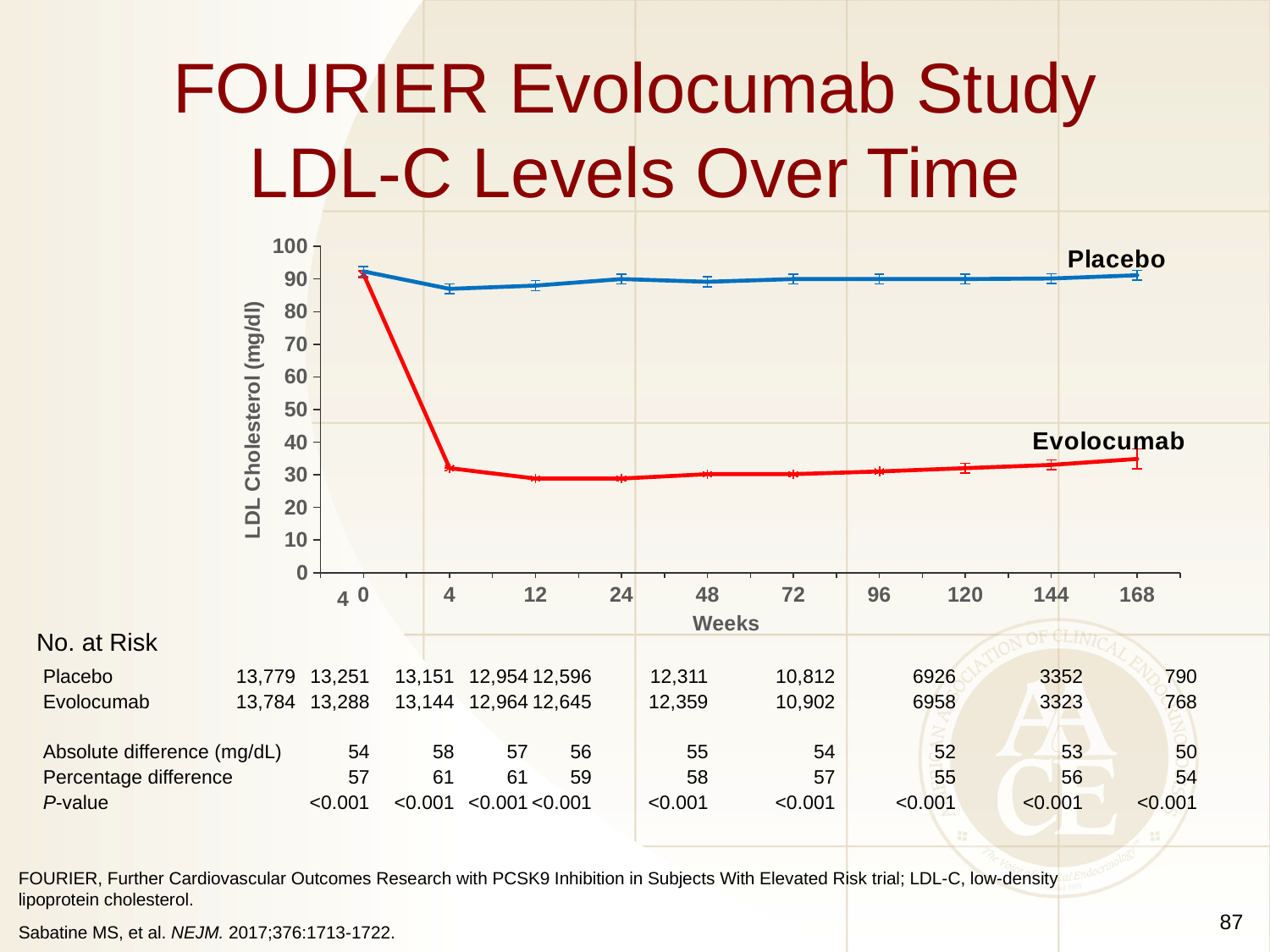
At week 48, which series has the higher value, Placebo or Evolocumab? Placebo What kind of chart is shown on the slide? line chart Is the value for Evolocumab at week 0 greater or less than 80? greater Which series has the lowest value on the chart at week 12? Evolocumab What is the label of the y axis of the chart? LDL Cholesterol (mg/dl) What are the names of the two series plotted on the chart? Placebo and Evolocumab Is the value for Evolocumab at week 4 greater or less than 50? less How many series are plotted on the chart? 2 Is the value for Placebo at week 168 greater or less than 80? greater Does the Evolocumab line rise or fall between week 0 and week 4? fall How many time points are labelled on the x axis of the chart? 10